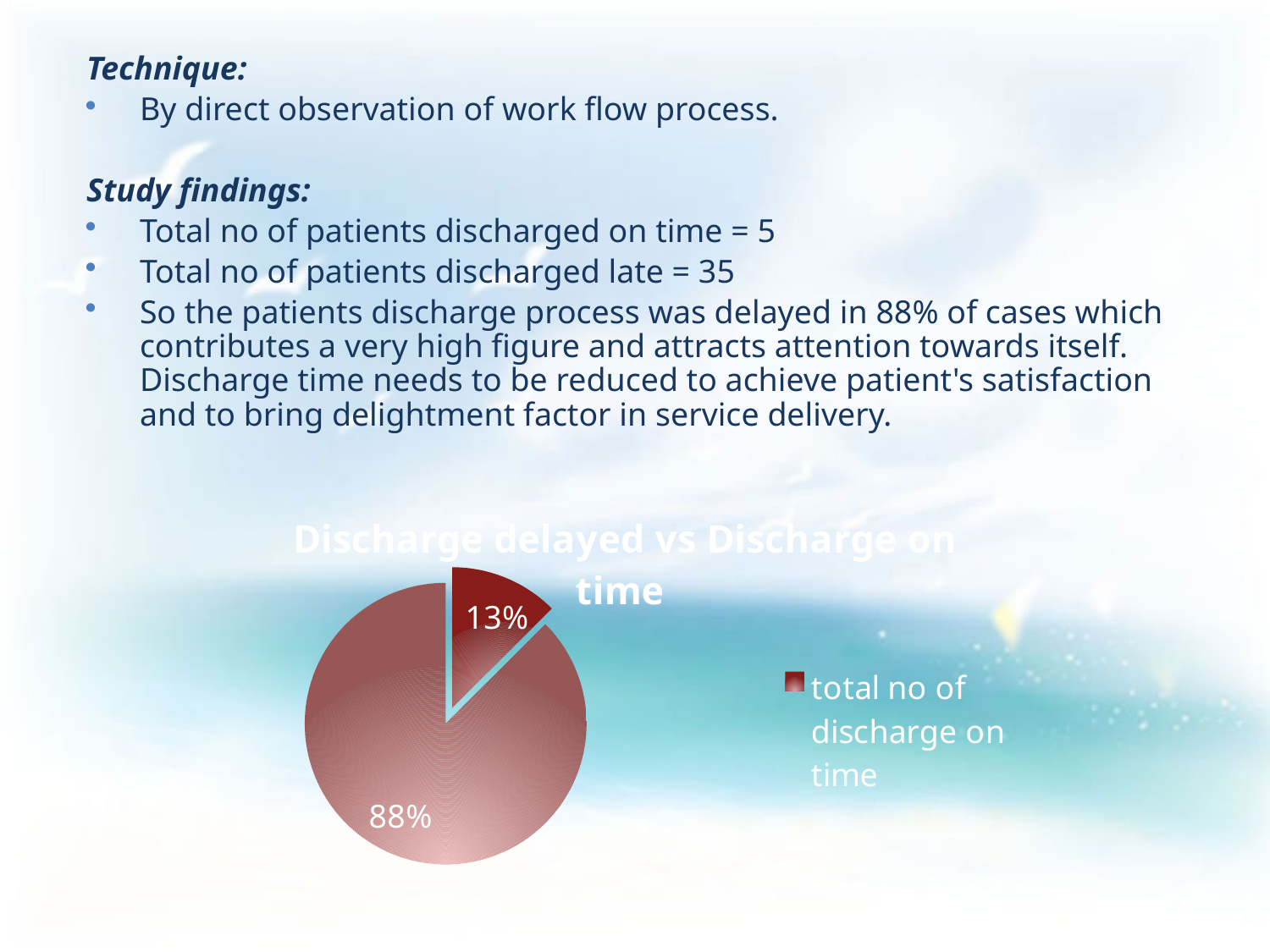
What percentage is shown on the smallest slice of the pie chart? 13% What share of the pie does the slice for 'total no of discharge on time' represent? 13% What is the title of the chart? Discharge delayed vs Discharge on time What is the difference in percentage points between the two slices of the pie chart? 75% Is the slice labelled 88% larger or smaller than half of the pie? larger What legend entry is readable next to the pie chart? total no of discharge on time What percentage is shown on the largest slice of the pie chart? 88% How many slices does the pie chart have? 2 Which slice is larger: the one labelled 88% or the one labelled 13%? 88% What kind of chart is shown on the slide? pie chart